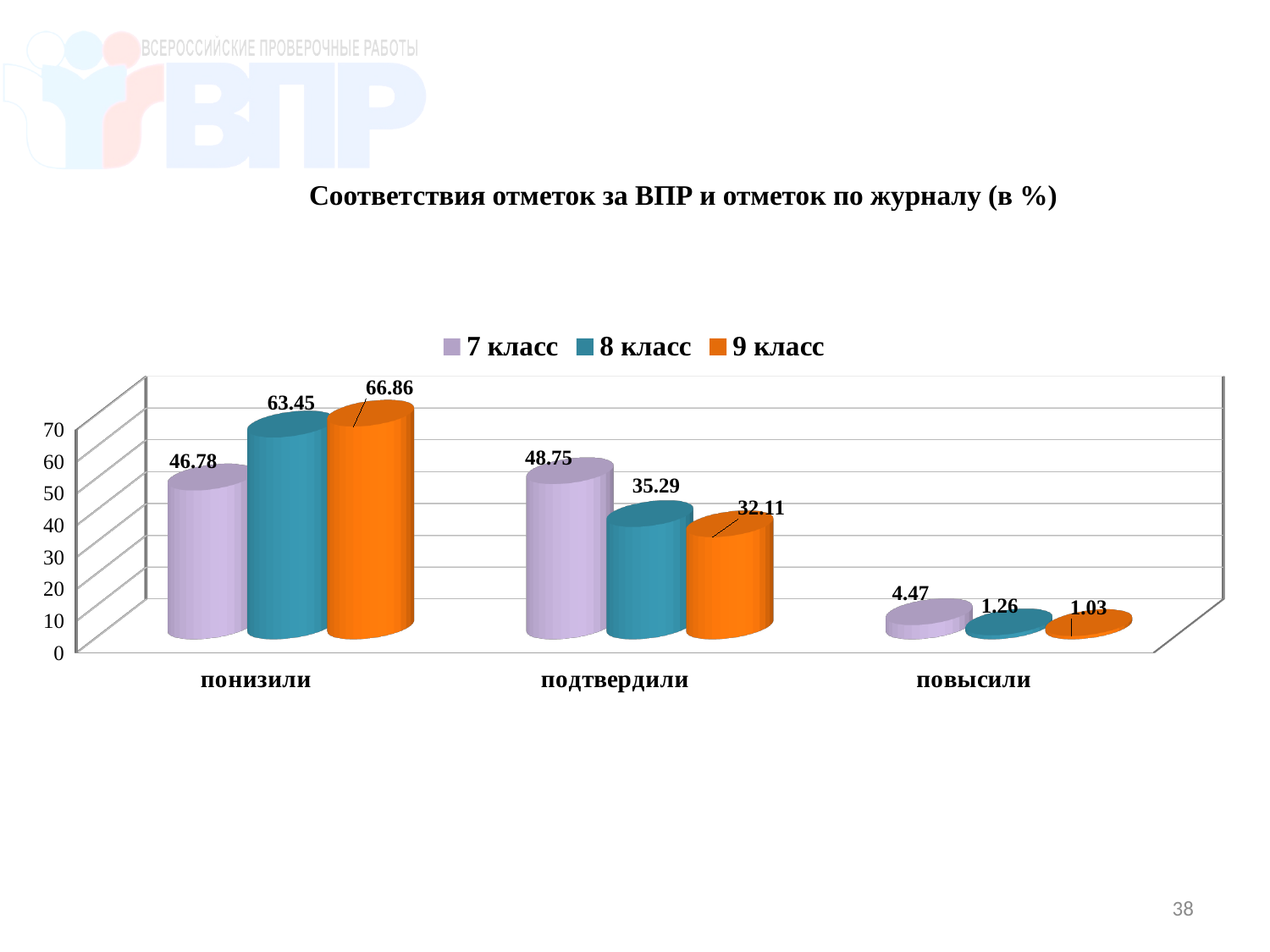
What kind of chart is shown on the slide? bar chart Which series has the lowest value in the повысили category? 9 класс What is the value for 7 класс in the понизили category? 46.78 How many series does the legend list? 3 What is the difference between the 9 класс and 7 класс values in the понизили category? 20.08 What is the value for 8 класс in the повысили category? 1.26 Which is larger: the 7 класс value for подтвердили or the 8 класс value for подтвердили? 7 класс What is the value for 9 класс in the подтвердили category? 32.11 How many categories are shown on the x axis? 3 Which series has the highest value in the понизили category? 9 класс Is the value for 8 класс in the понизили category greater or less than 60? greater What is the title of the chart? Соответствия отметок за ВПР и отметок по журналу (в %)